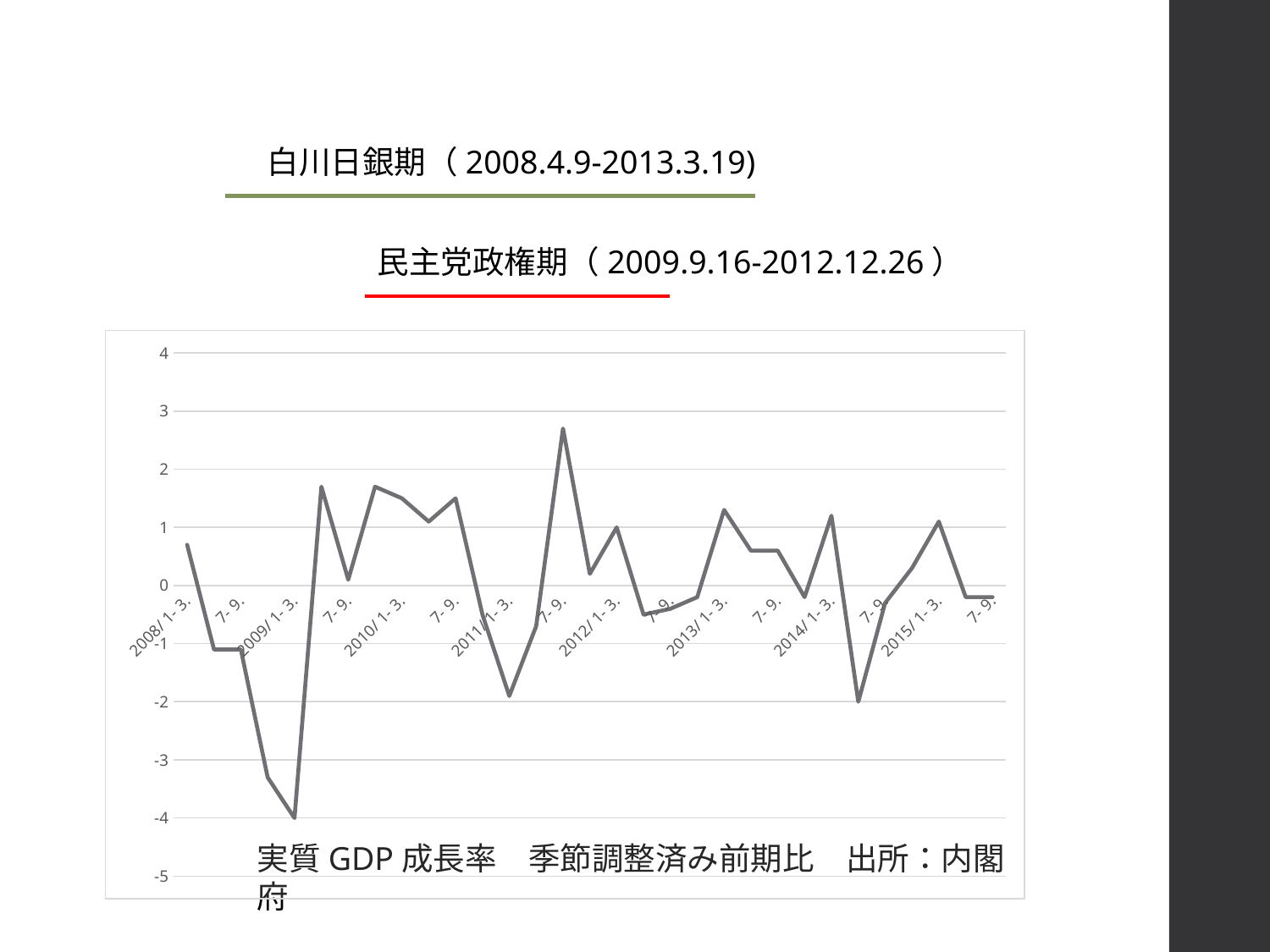
According to the caption on the chart, what is the source of the data? 内閣府 Is the value for 2010/1-3 greater or less than 1? greater How many lines are plotted on the chart? 1 Which is larger, the value for 2011/7-9 or the value for 2010/1-3? 2011/7-9 Which is larger, the value for 2009/1-3 or the value for 2014/7-9? 2014/7-9 Which quarter has the highest value on the chart? 2011/7-9 Is the value for 2011/7-9 greater or less than 2? greater Which quarter has the lowest value on the chart? 2009/1-3 Is the value for 2008/1-3 greater or less than 0? greater What kind of chart is shown on the slide? line chart